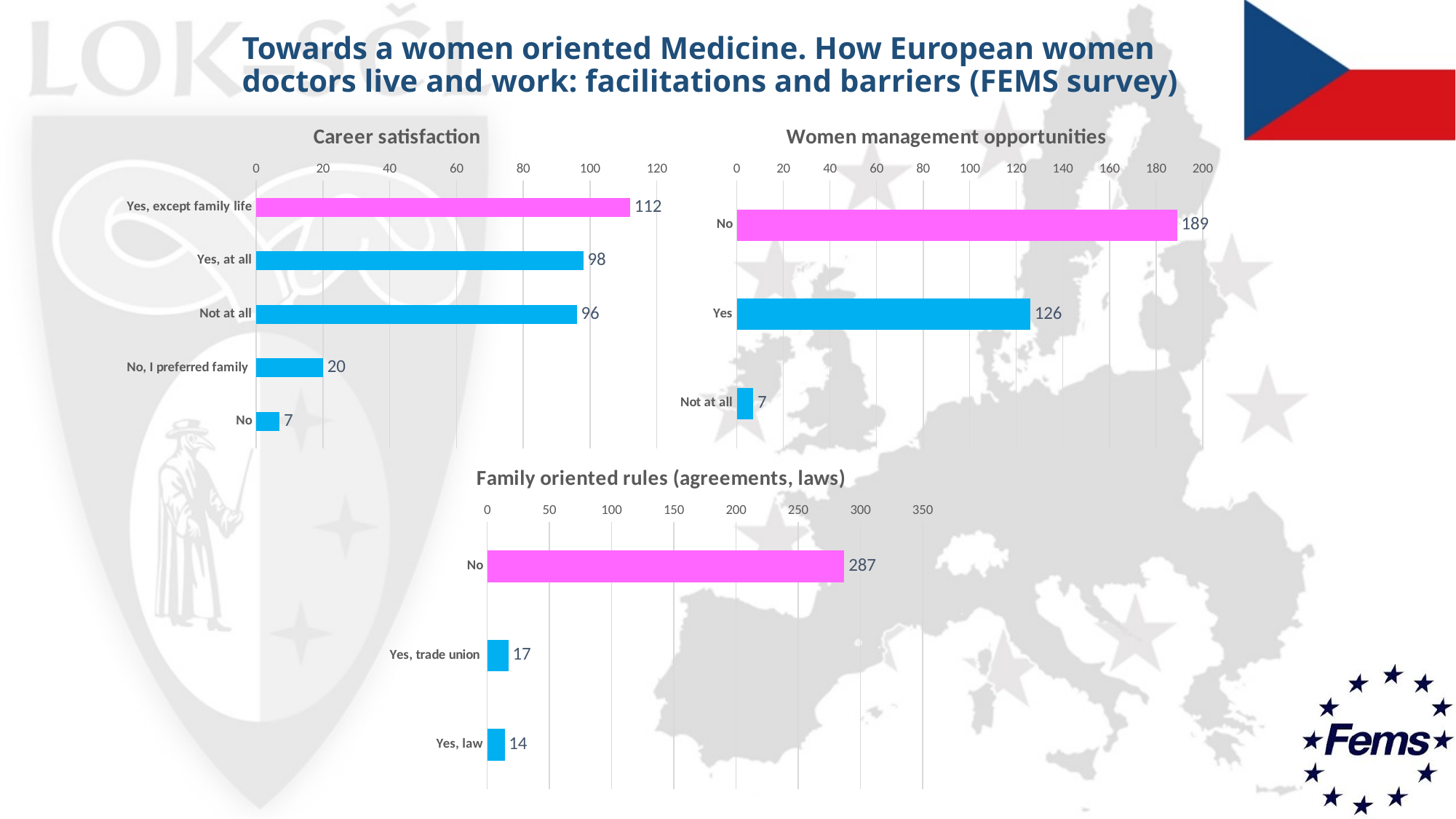
In the 'Women management opportunities' chart, which category has the highest value? No In the 'Women management opportunities' chart, what colour is the bar for 'No'? Pink In the 'Women management opportunities' chart, what is the value for 'Yes'? 126 In the 'Career satisfaction' chart, what is the difference between 'Yes, at all' and 'Not at all'? 2 In the 'Women management opportunities' chart, what is the difference between 'No' and 'Yes'? 63 In the 'Career satisfaction' chart, which category has the lowest value? No In the 'Family oriented rules (agreements, laws)' chart, how many categories are shown? 3 What type of chart is the 'Career satisfaction' chart? Bar chart In the 'Family oriented rules (agreements, laws)' chart, which is larger, 'Yes, trade union' or 'Yes, law'? Yes, trade union In the 'Career satisfaction' chart, what is the value for 'Yes, except family life'? 112 In the 'Family oriented rules (agreements, laws)' chart, what is the value for 'No'? 287 In the 'Career satisfaction' chart, how many categories are shown? 5